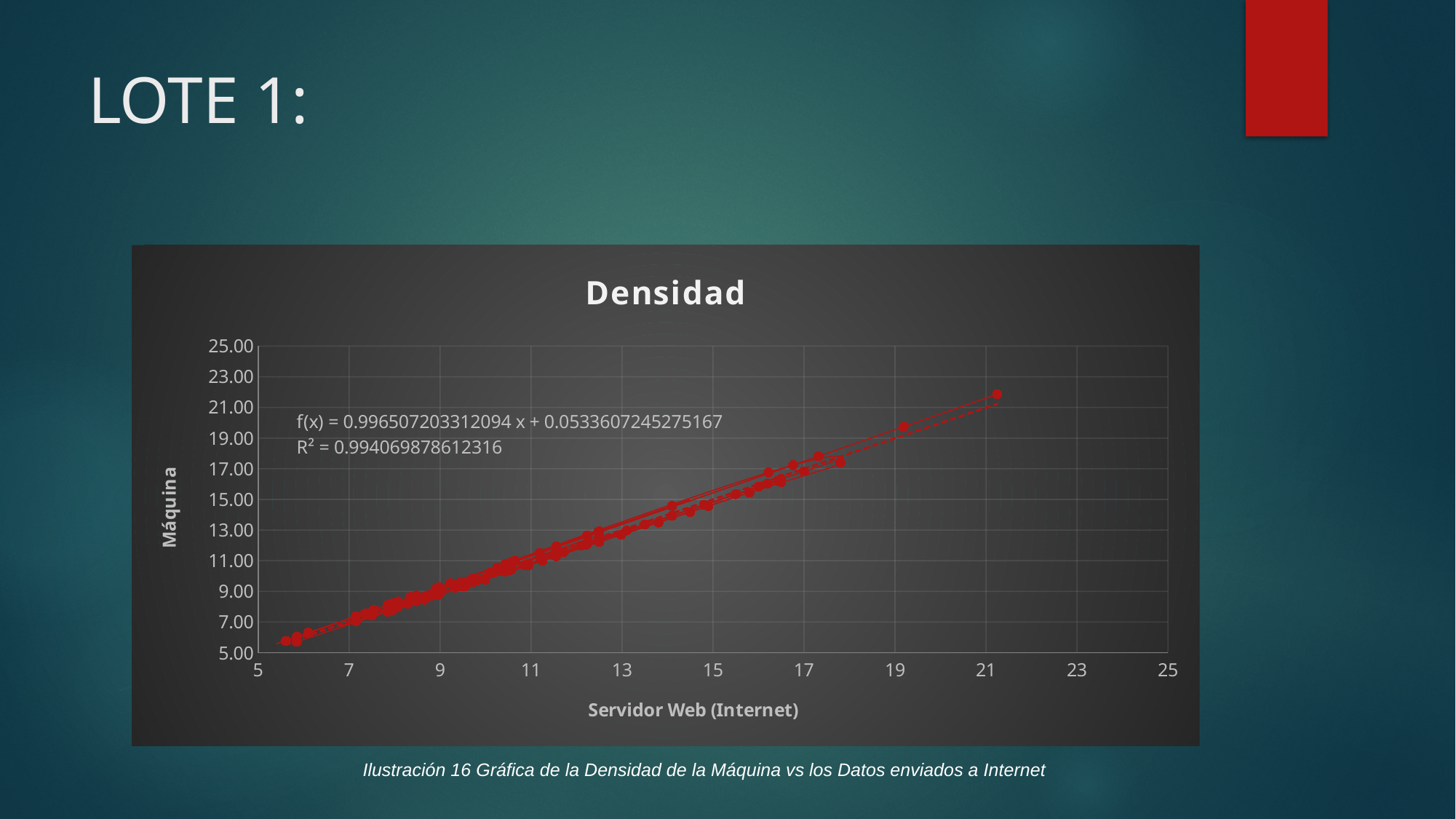
What is the trendline equation printed on the chart? f(x) = 0.996507203312094 x + 0.0533607245275167 What is the title of the chart? Densidad Is the Máquina value of the leftmost point (near x = 5.5) greater or less than 7.00? less What R² value is printed on the chart? R² = 0.994069878612316 Is the Máquina value of the rightmost point (near x = 21) greater or less than 19.00? greater What is the slope of the trendline shown in the equation on the chart? 0.996507203312094 What is the highest tick value shown on the y axis? 25.00 Do the Máquina values rise or fall as the Servidor Web (Internet) values increase? Rise What is the lowest tick value shown on the x axis? 5 What kind of chart is shown on the slide? Scatter chart What is the label of the x axis? Servidor Web (Internet) Is the Máquina value of the point near x = 13 greater or less than 15.00? less